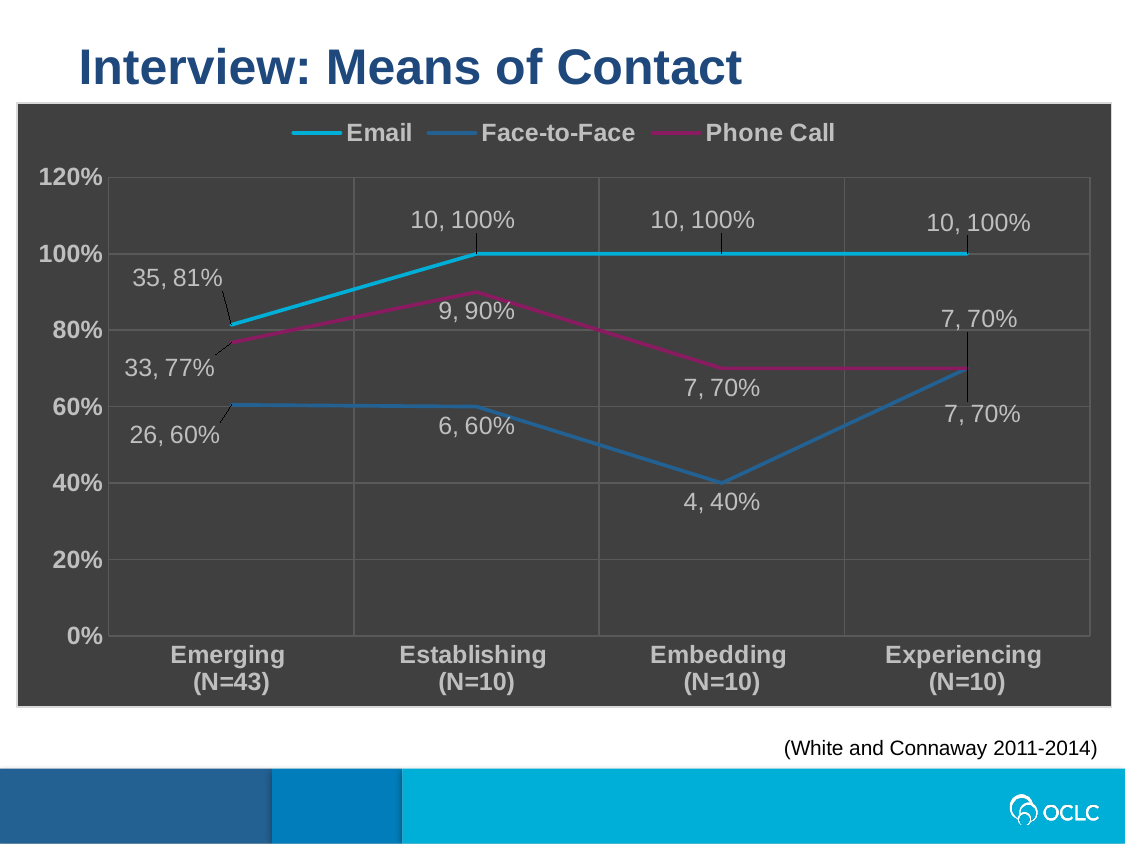
How many series does the legend list? 3 Does the Face-to-Face line rise or fall from Establishing (N=10) to Embedding (N=10)? fall What is the title of the slide? Interview: Means of Contact What data label is shown for Phone Call in the Establishing (N=10) category? 9, 90% How many categories are shown on the x axis? 4 What percentage is shown for Face-to-Face in the Embedding (N=10) category? 40% What is the difference in percentage points between Email and Face-to-Face in the Experiencing (N=10) category? 30 Which series has the lowest value in the Embedding (N=10) category? Face-to-Face Which series has the highest value in the Establishing (N=10) category? Email Which is larger in the Emerging (N=43) category, Phone Call or Face-to-Face? Phone Call What percentage is shown for Email in the Emerging (N=43) category? 81% What type of chart is shown on the slide? line chart